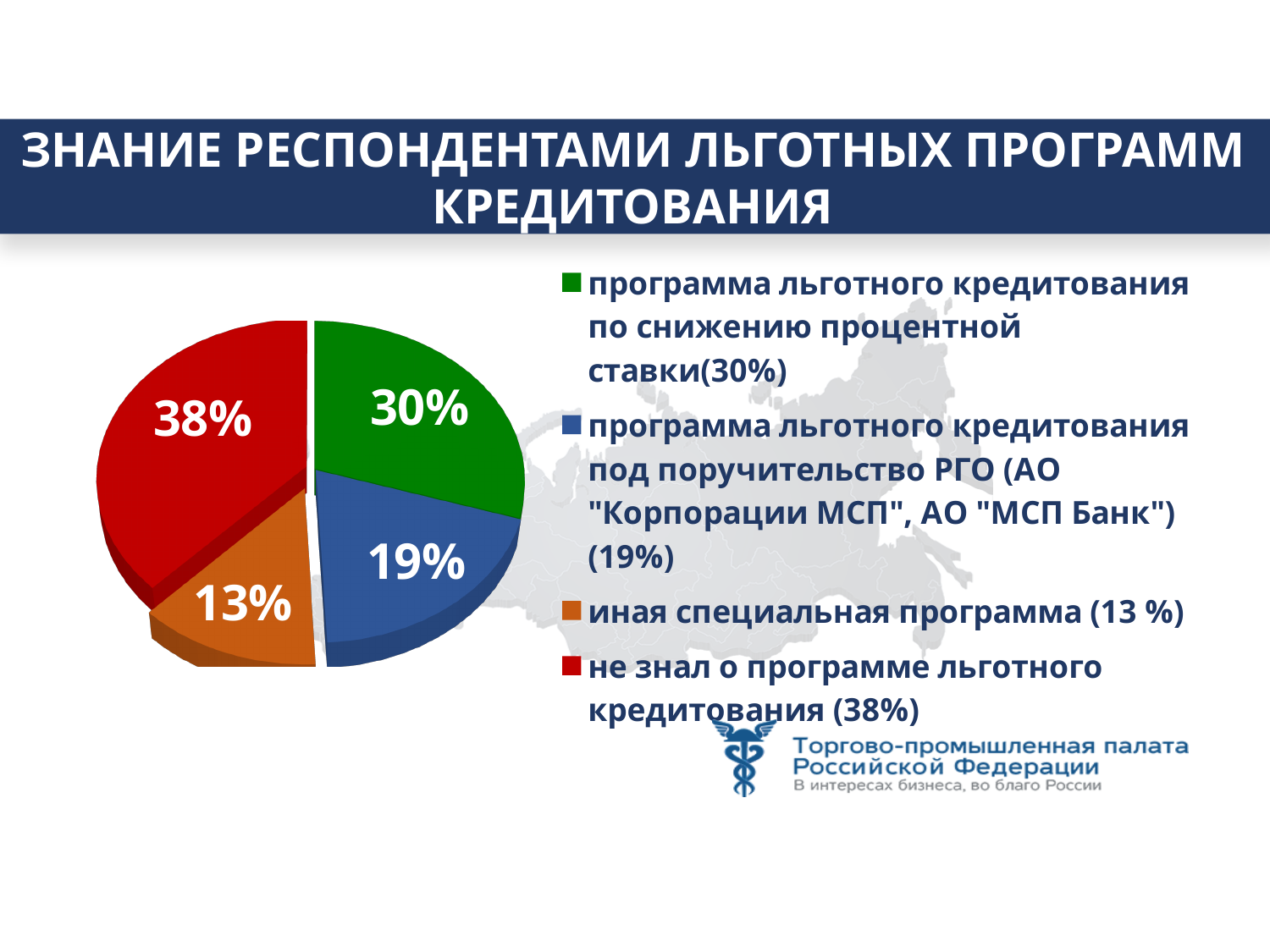
What share of respondents knew the preferential lending programme for reducing the interest rate (по снижению процентной ставки)? 30% Which category has the largest slice of the pie? не знал о программе льготного кредитования Which is larger: the share for the programme under RGO guarantee or the share for another special programme? программа льготного кредитования под поручительство РГО How many slices does the pie chart have? 4 What share of respondents named another special programme (иная специальная программа)? 13% What kind of chart is shown on the slide? Pie chart What is the title of the slide? ЗНАНИЕ РЕСПОНДЕНТАМИ ЛЬГОТНЫХ ПРОГРАММ КРЕДИТОВАНИЯ What share of respondents knew the preferential lending programme under RGO guarantee (под поручительство РГО)? 19% What is the difference in percentage points between the 38% slice and the 30% slice? 8 Which category has the smallest slice of the pie? иная специальная программа What colour is the slice for respondents who did not know about the preferential lending programme? Red What share of respondents did not know about the preferential lending programme (не знал о программе льготного кредитования)? 38%